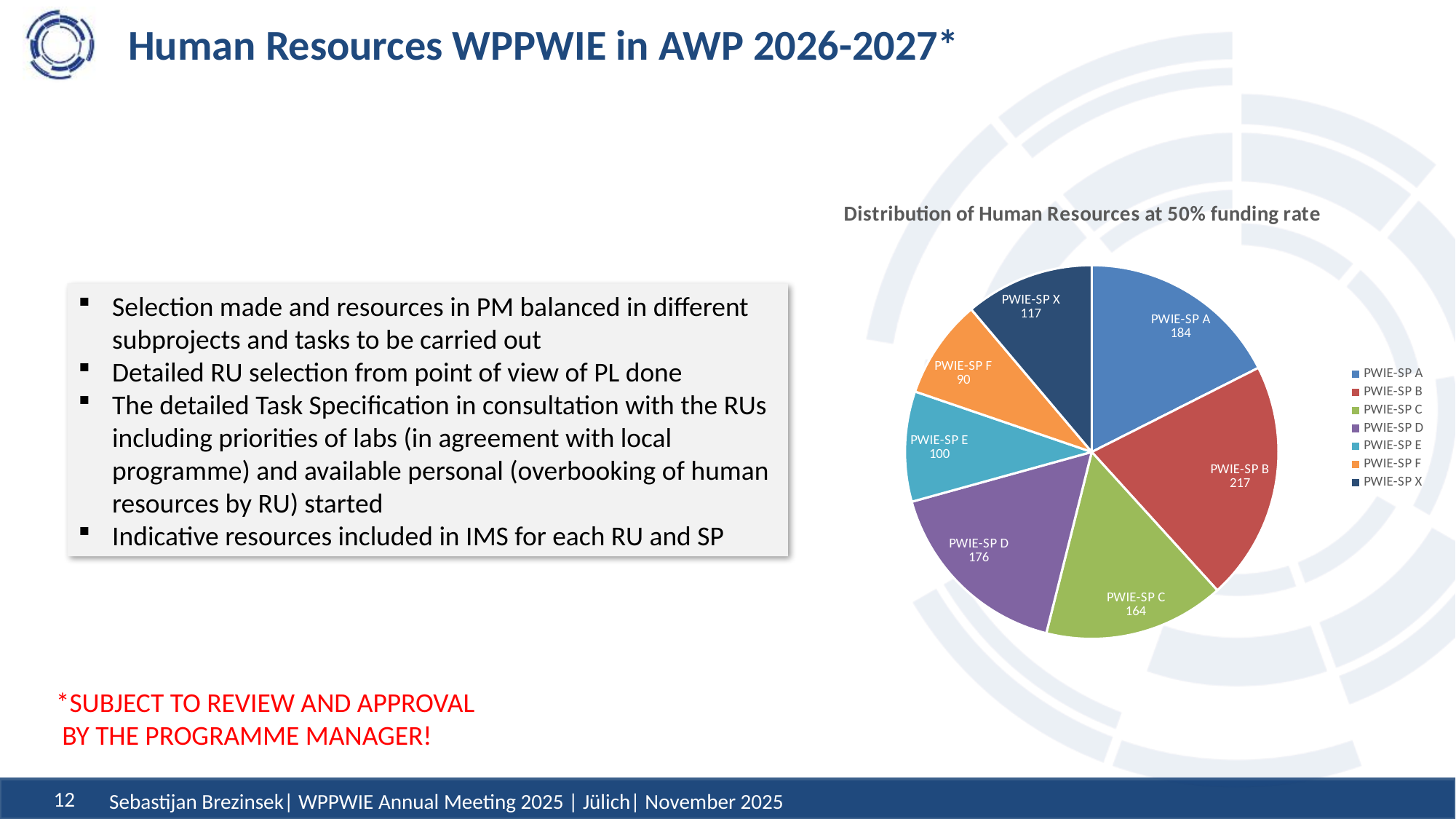
Which is larger, the value for PWIE-SP A or PWIE-SP D? PWIE-SP A Which subproject has the largest slice in the pie chart? PWIE-SP B What is the value for PWIE-SP B in the pie chart? 217 What is the value for PWIE-SP E in the pie chart? 100 What is the difference between the values for PWIE-SP B and PWIE-SP A? 33 What is the difference between the values for PWIE-SP D and PWIE-SP C? 12 How many entries does the legend of the pie chart list? 7 How many slices does the pie chart have? 7 What is the title of the pie chart? Distribution of Human Resources at 50% funding rate Which subproject has the smallest slice in the pie chart? PWIE-SP F What type of chart is shown on the slide? Pie chart What is the value for PWIE-SP X in the pie chart? 117